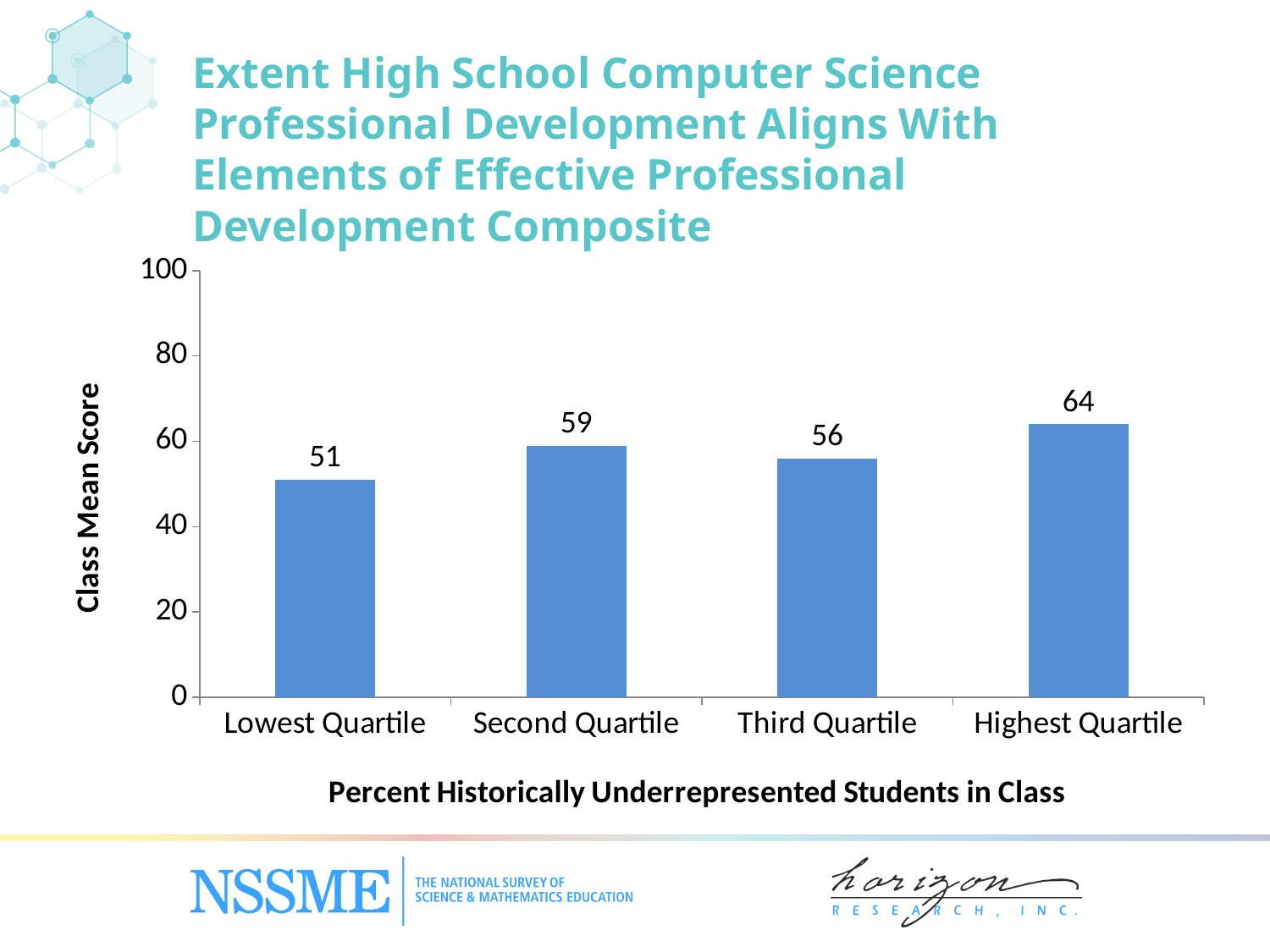
What is the class mean score for the Highest Quartile? 64 Which quartile has the highest class mean score? Highest Quartile What is the label of the x axis? Percent Historically Underrepresented Students in Class Is the value for the Highest Quartile greater or less than 60? greater What kind of chart is shown on the slide? bar chart How many quartile categories are shown on the x axis? 4 Which has a higher class mean score, the Second Quartile or the Third Quartile? Second Quartile What is the class mean score for the Third Quartile? 56 What is the difference between the class mean scores of the Highest Quartile and the Lowest Quartile? 13 What is the class mean score for the Second Quartile? 59 What is the class mean score for the Lowest Quartile? 51 Which quartile has the lowest class mean score? Lowest Quartile